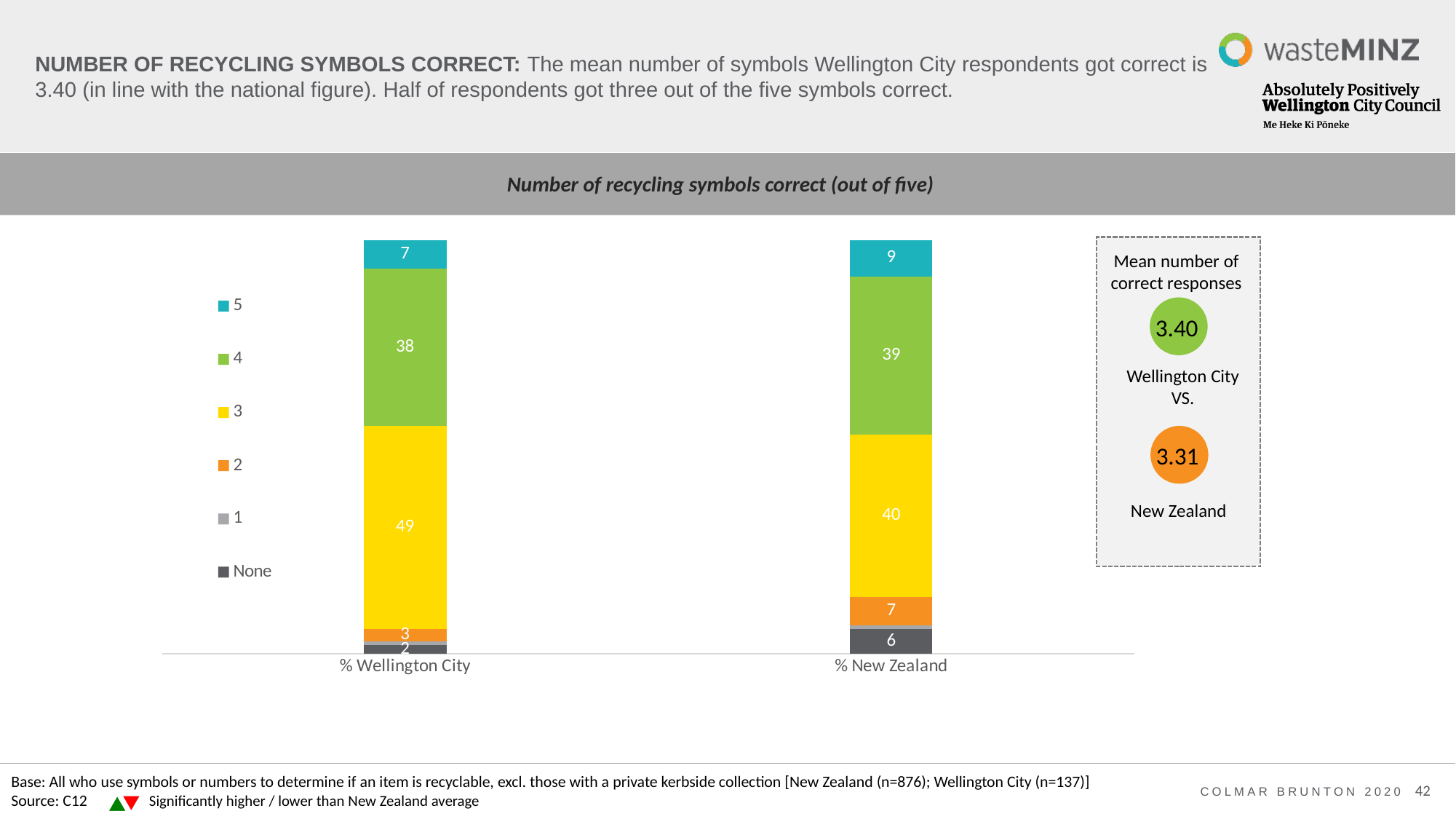
How many bars (categories) are plotted on the chart? 2 Which colour represents the '5' series in the legend? Teal/blue What is the title of the chart? Number of recycling symbols correct (out of five) How many series does the chart legend list? 6 Which is larger: the value for 2 symbols correct in Wellington City or in New Zealand? New Zealand What percentage of New Zealand respondents got none of the symbols correct? 6 What percentage of New Zealand respondents got 4 symbols correct? 39 Which segment is the largest in the % Wellington City bar? 3 What type of chart is shown on the slide? Stacked bar chart What percentage of Wellington City respondents got 3 symbols correct? 49 What is the difference between the Wellington City and New Zealand values for 3 symbols correct? 9 What percentage of Wellington City respondents got all 5 symbols correct? 7